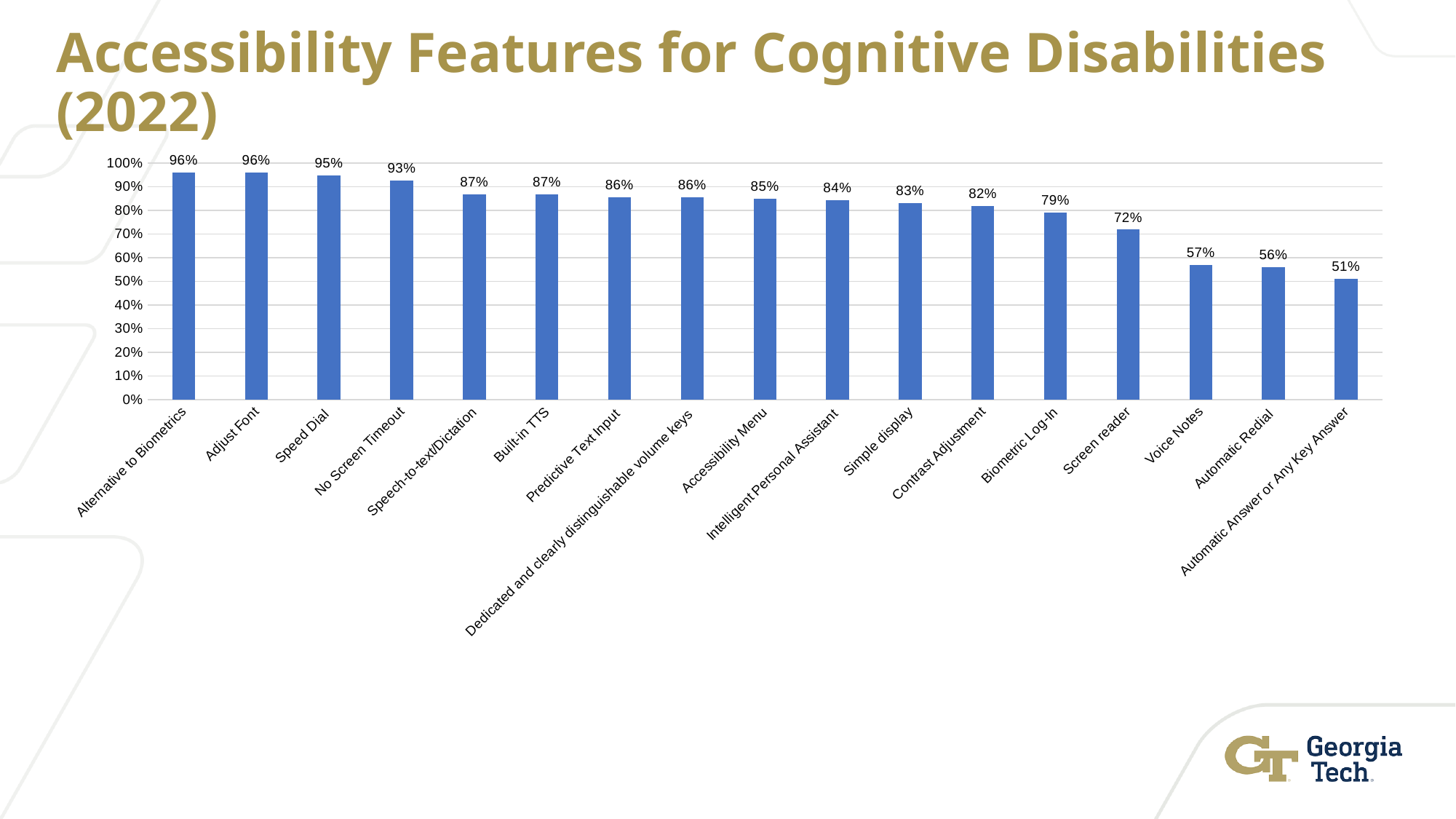
How many features are shown in the chart? 17 Is the value for Intelligent Personal Assistant greater or less than 70%? greater What is the difference between the values for Alternative to Biometrics and Automatic Answer or Any Key Answer? 45% What kind of chart is shown on the slide? bar chart What is the value for Biometric Log-In? 79% What is the value for Voice Notes? 57% Which is larger, the value for Contrast Adjustment or the value for Automatic Redial? Contrast Adjustment What is the difference between the values for No Screen Timeout and Screen reader? 21% What is the value for Screen reader? 72% What is the value for Speed Dial? 95% Do the values rise or fall from left to right along the x axis? fall Which feature has the lowest value? Automatic Answer or Any Key Answer